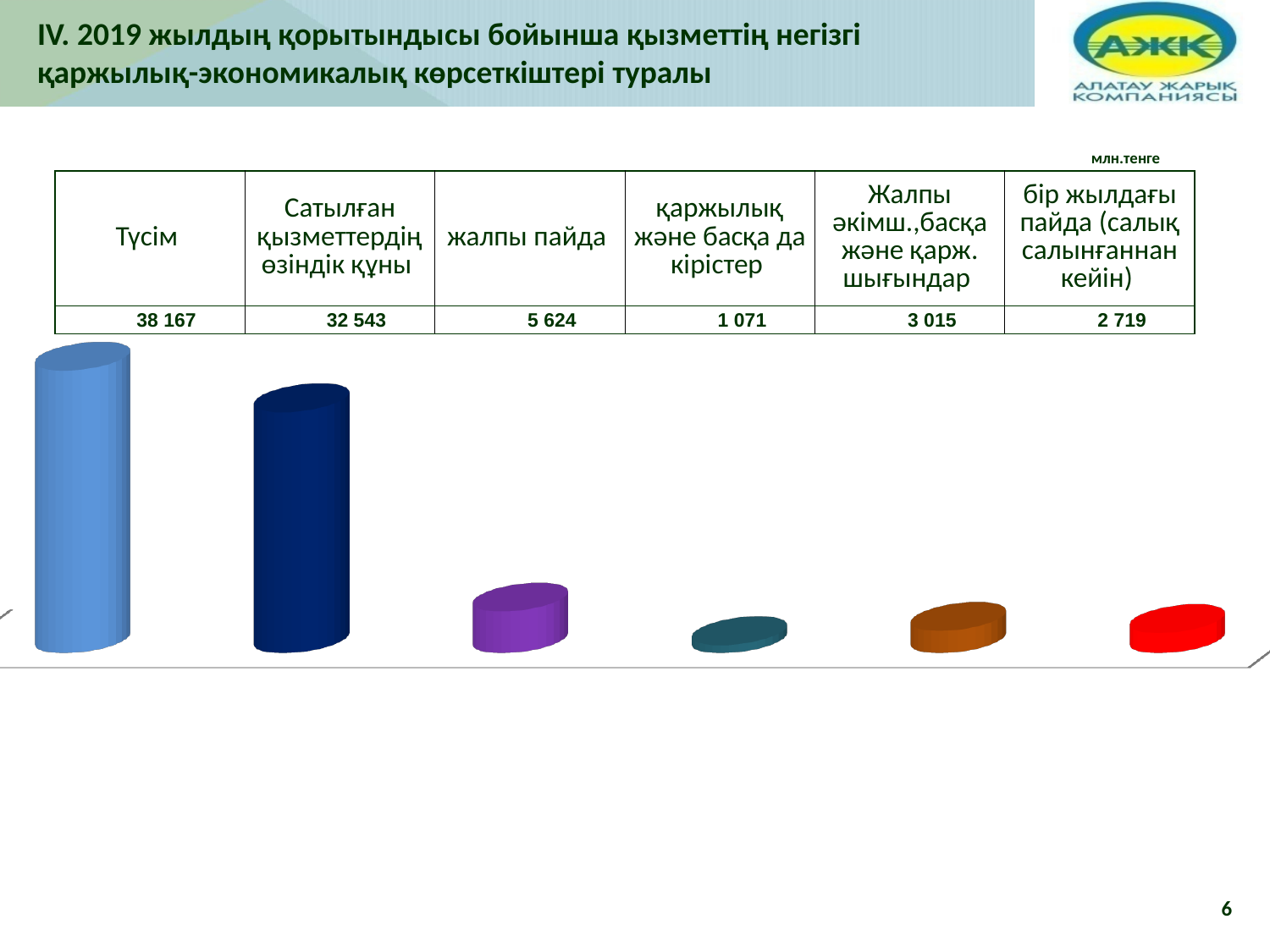
In what unit are the values given? млн.тенге What is the value for қаржылық және басқа да кірістер? 1 071 How many bars does the chart show? 6 What is the value for Түсім? 38 167 What is the difference between Түсім and Сатылған қызметтердің өзіндік құны? 5 624 What kind of chart is shown on the slide? bar chart What is the value for Сатылған қызметтердің өзіндік құны? 32 543 Which category has the lowest value? қаржылық және басқа да кірістер Which category has the highest value? Түсім Which is larger: Жалпы әкімш.,басқа және қарж. шығындар or бір жылдағы пайда (салық салынғаннан кейін)? Жалпы әкімш.,басқа және қарж. шығындар What is the value for жалпы пайда? 5 624 What is the value for бір жылдағы пайда (салық салынғаннан кейін)? 2 719